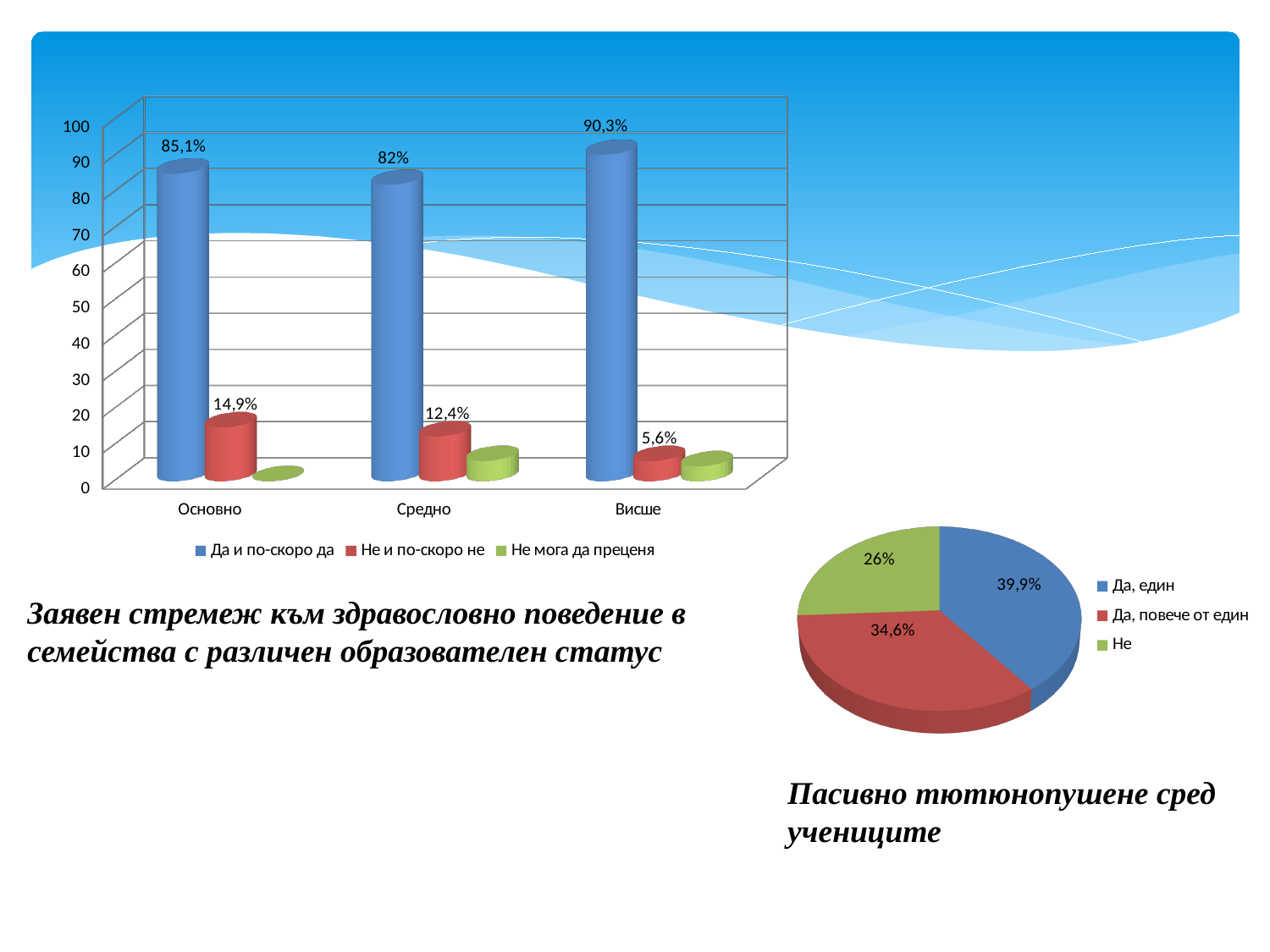
In the bar chart on the left, how many series does the legend list? 3 In the pie chart on the right, what share does 'Да, един' have? 39,9% In the bar chart on the left, what is the difference between the 'Да и по-скоро да' values for Висше and Средно? 8,3% In the bar chart on the left, what is the value of 'Да и по-скоро да' for Средно? 82% In the bar chart on the left, is the 'Не и по-скоро не' value for Средно larger or smaller than for Основно? smaller In the bar chart on the left, which category has the lowest value for 'Не и по-скоро не'? Висше In the bar chart on the left, what is the value of 'Не и по-скоро не' for Основно? 14,9% In the bar chart on the left, which category has the highest value for 'Да и по-скоро да'? Висше What kind of chart is shown on the right of the slide? pie chart In the pie chart on the right, which slice is the smallest? Не In the bar chart on the left, how many categories are shown on the x axis? 3 In the bar chart on the left, what is the value of 'Да и по-скоро да' for Висше? 90,3%